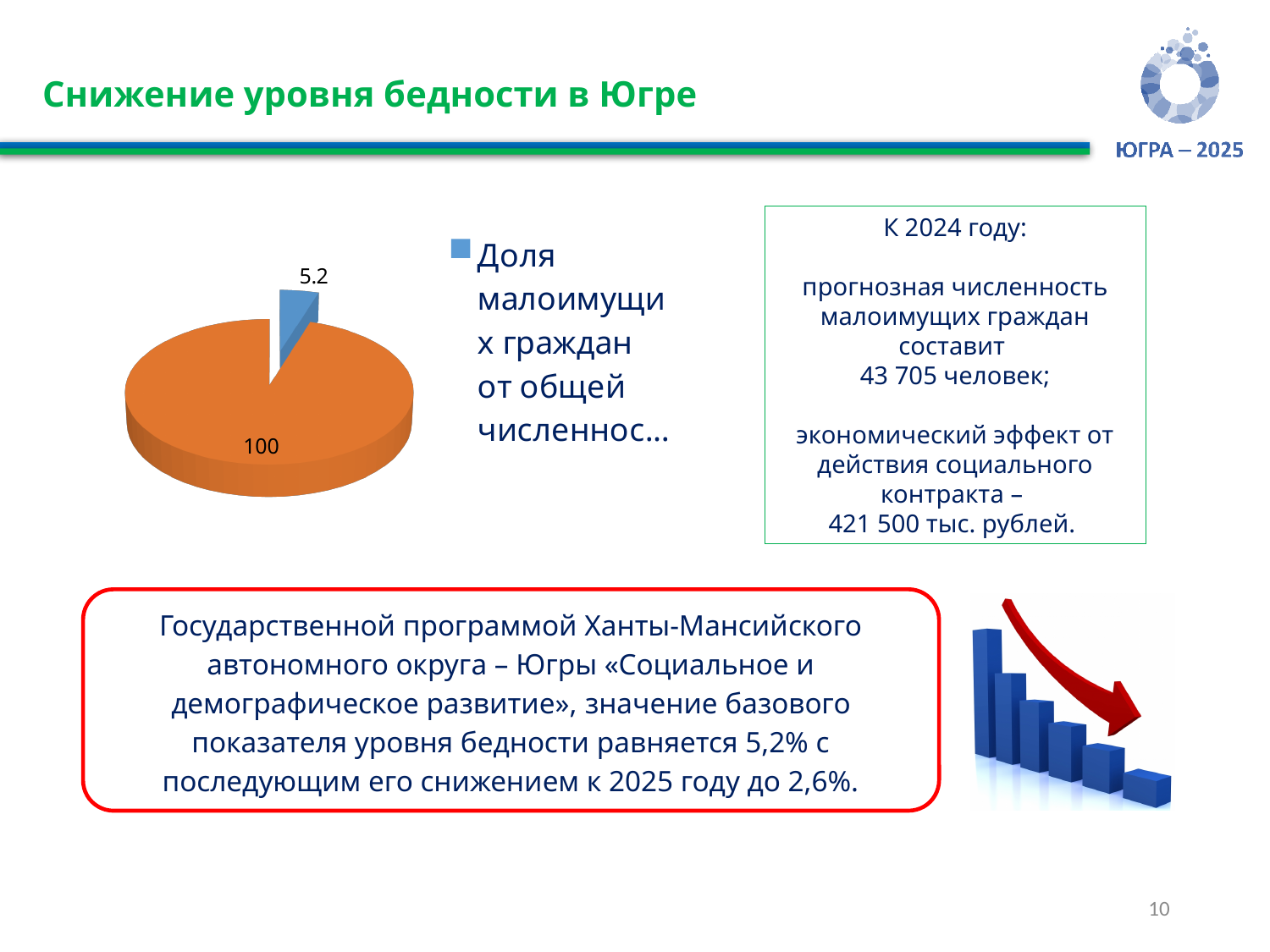
What colour is the slice labelled 100 in the pie chart? orange How many entries does the legend of the pie chart list? 1 What kind of chart is shown on the slide? pie chart What colour is the slice labelled 5.2 in the pie chart? blue Which slice of the pie chart has the smallest value? the blue slice (5.2) Which slice of the pie chart has the largest value? the orange slice (100) What value is printed on the small blue slice of the pie chart? 5.2 What value is printed on the large orange slice of the pie chart? 100 What is the difference between the values printed on the orange slice and the blue slice? 94.8 How many slices does the pie chart have? 2 Is the value of the blue slice larger or smaller than the value of the orange slice? smaller